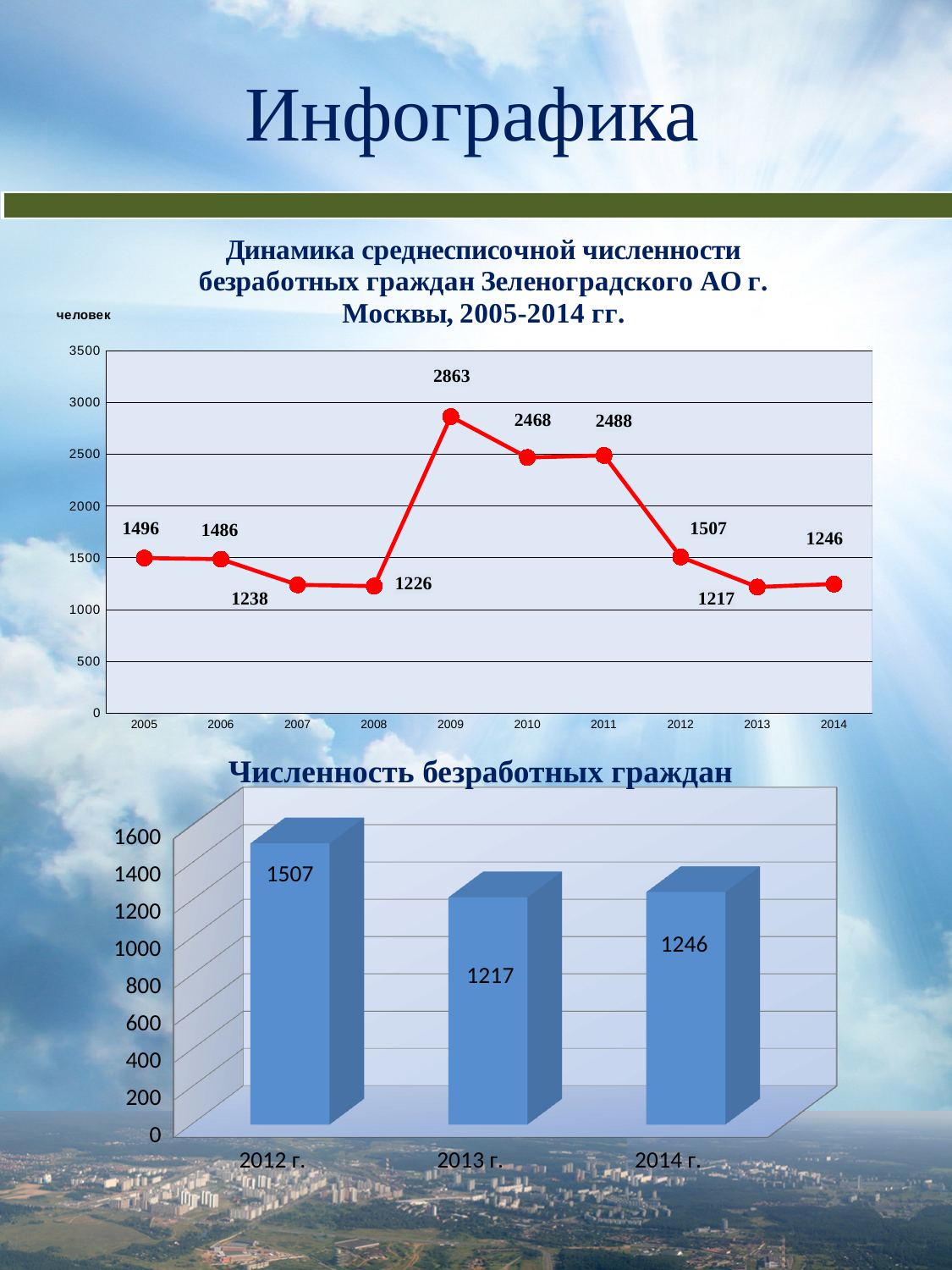
In the top chart, which is larger, the value for 2005 or the value for 2006? 2005 What kind of chart is the top chart? line chart In the top chart, do the values rise or fall from 2011 to 2013? fall In the bottom chart, what is the difference between the values for 2012 г. and 2014 г.? 261 What kind of chart is the bottom chart? bar chart In the top chart, which year has the lowest value? 2013 In the top chart, which year has the highest value? 2009 In the top chart, what is the difference between the values for 2011 and 2010? 20 What unit label is shown above the y axis of the top chart? человек In the top chart (Динамика среднесписочной численности безработных граждан), what is the value for 2009? 2863 In the top chart, how many years are plotted on the x axis? 10 In the bottom chart (Численность безработных граждан), what is the value for 2013 г.? 1217